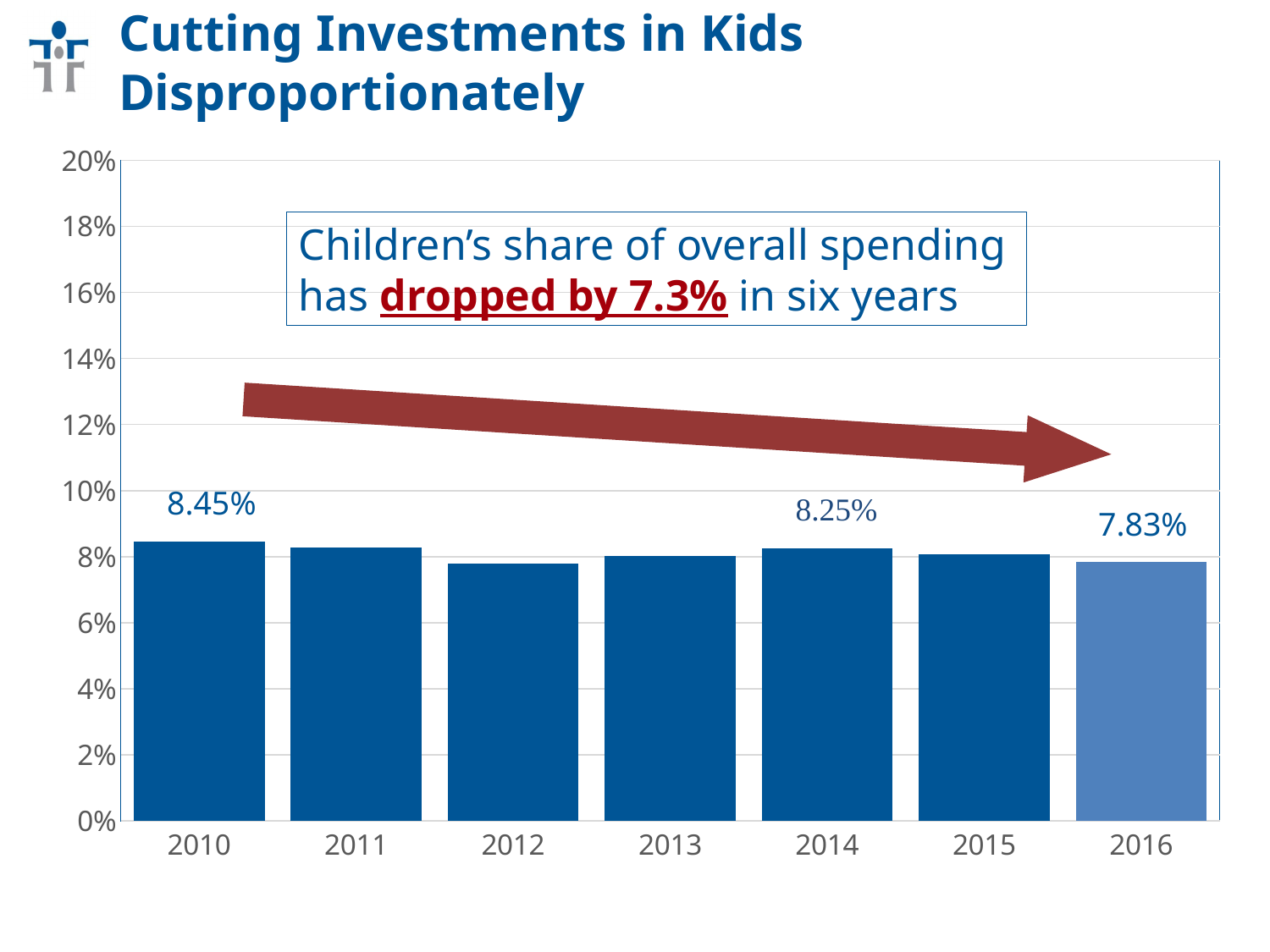
Which is larger, the value for 2010 or the value for 2016? 2010 Is the value for 2015 greater or less than 6%? greater What is the difference between the values for 2010 and 2014? 0.20% How many years are shown on the x axis? 7 Which is larger, the value for 2014 or the value for 2016? 2014 Do the values generally rise or fall from 2010 to 2016? fall What is the value for 2010? 8.45% Is the value for 2012 greater or less than 10%? less What is the value for 2014? 8.25% What is the value for 2016? 7.83% What kind of chart is shown on the slide? bar chart What is the difference between the values for 2010 and 2016? 0.62%